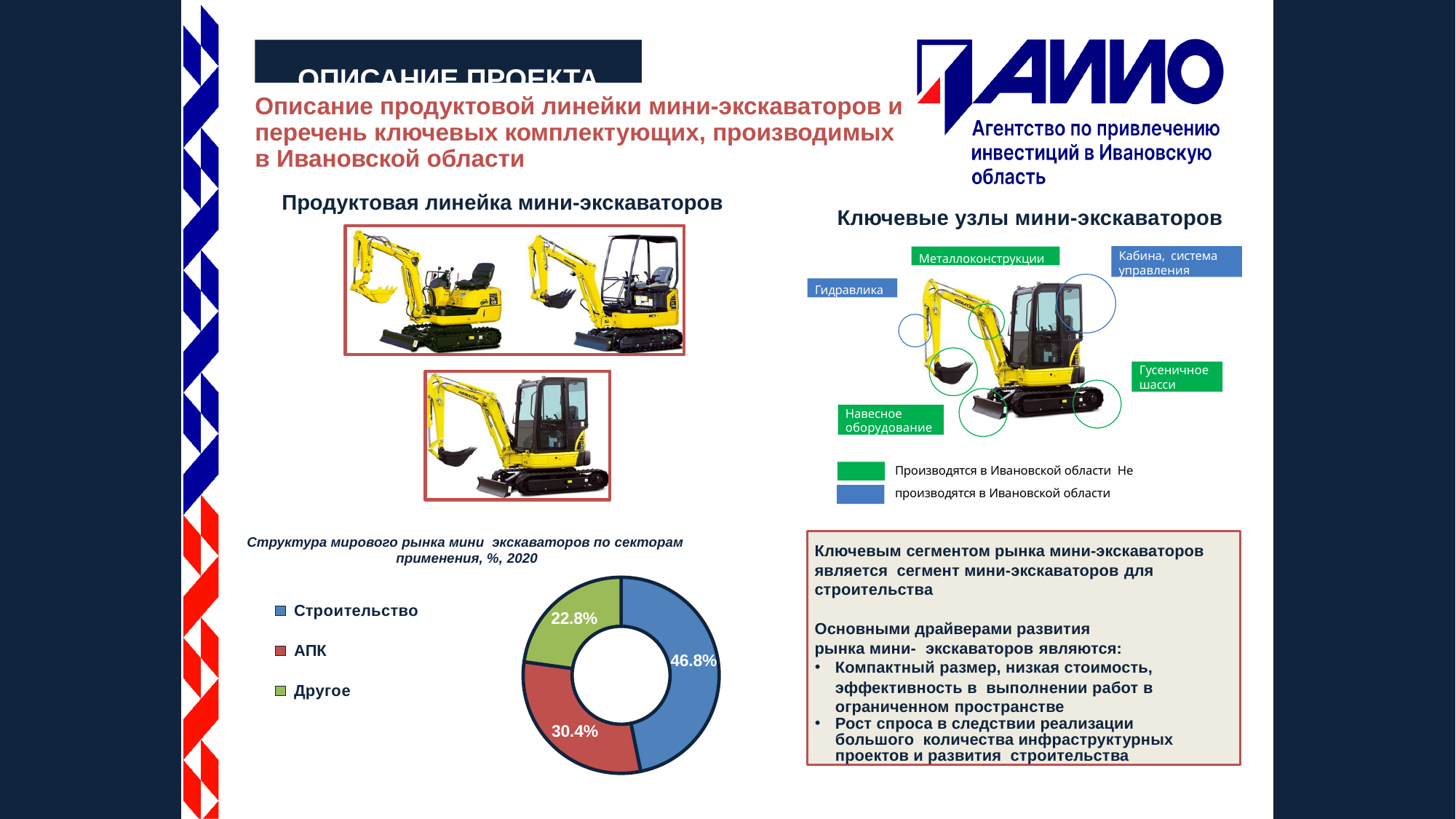
What is the share of Строительство in the chart? 46.8% What is the title of the chart? Структура мирового рынка мини экскаваторов по секторам применения, %, 2020 What kind of chart is shown on the slide? Doughnut (pie) chart Which is larger, the share of АПК or the share of Другое? АПК What is the share of Другое in the chart? 22.8% What is the share of АПК in the chart? 30.4% Which sector has the smallest share in the chart? Другое How many sectors are shown in the chart? 3 What is the difference between the shares of АПК and Другое? 7.6% What is the difference between the shares of Строительство and АПК? 16.4% What colour represents Строительство in the chart? Blue Which sector has the largest share in the chart? Строительство